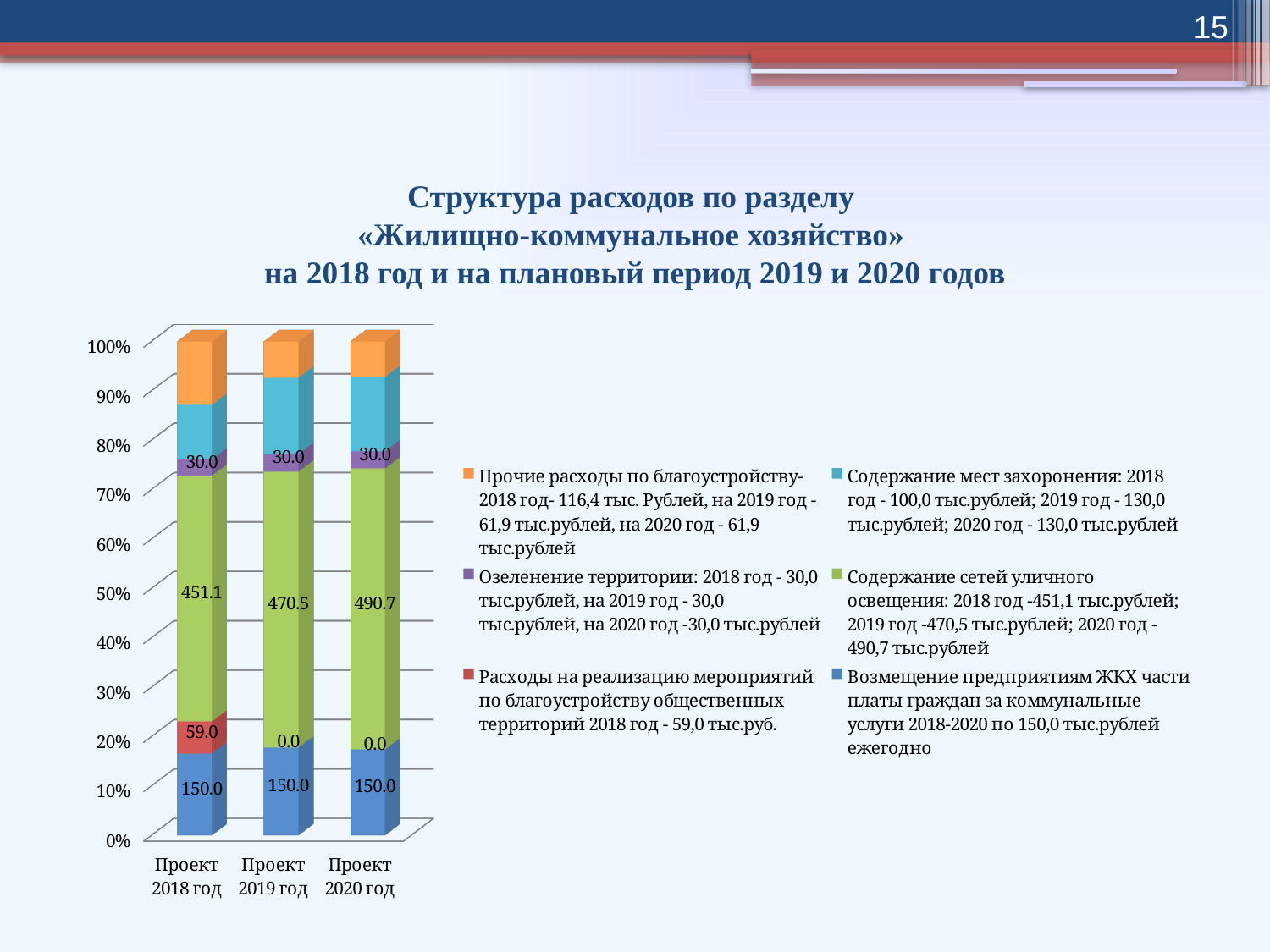
What is the value of the red series (Расходы на реализацию мероприятий по благоустройству общественных территорий) for Проект 2018 год? 59.0 What is the value of the green series (Содержание сетей уличного освещения) for Проект 2020 год? 490.7 Does the green series value rise or fall from Проект 2018 год to Проект 2020 год? rise What is the value of the blue series (Возмещение предприятиям ЖКХ) for Проект 2019 год? 150.0 What is the value of the purple series (Озеленение территории) for Проект 2020 год? 30.0 What is the difference between the green series values for Проект 2020 год and Проект 2019 год? 20.2 Which series is shown in orange in the chart legend? Прочие расходы по благоустройству How many series does the chart legend list? 6 What is the value of the green series (Содержание сетей уличного освещения) for Проект 2018 год? 451.1 What type of chart is shown on the slide? bar chart How many categories (projects) are shown on the x axis of the chart? 3 Which project has the highest value for the green series (Содержание сетей уличного освещения)? Проект 2020 год